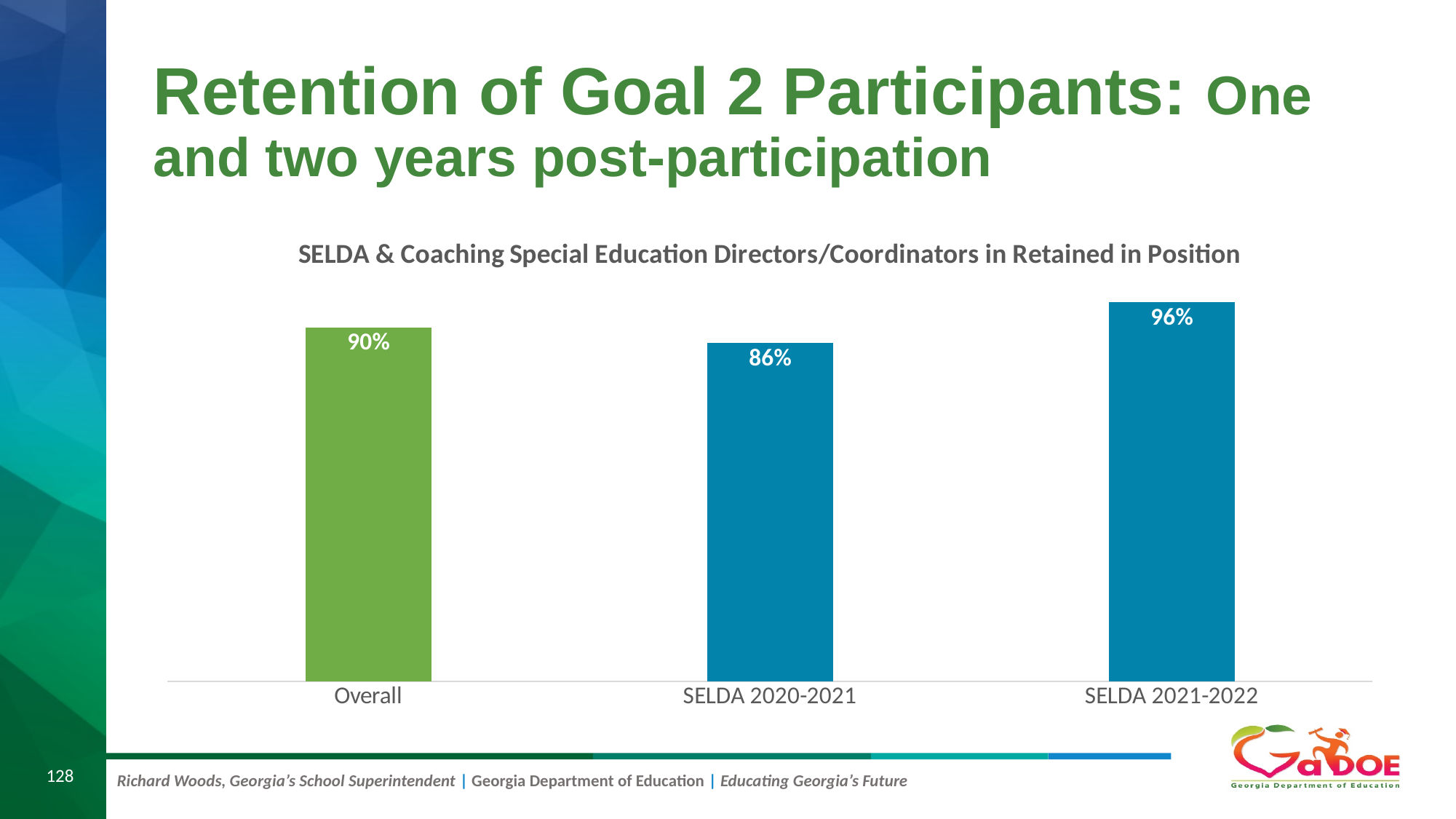
Which category has the highest value? SELDA 2021-2022 What is the title of the chart? SELDA & Coaching Special Education Directors/Coordinators in Retained in Position What is the value for SELDA 2021-2022? 96% Which category's bar is coloured green rather than blue? Overall What kind of chart is shown on the slide? Bar chart How many categories are shown in the chart? 3 Which category has the lowest value? SELDA 2020-2021 Which is larger, the value for Overall or the value for SELDA 2021-2022? SELDA 2021-2022 What is the value for SELDA 2020-2021? 86% What is the difference between the values for SELDA 2021-2022 and SELDA 2020-2021? 10% What is the difference between the values for Overall and SELDA 2020-2021? 4% What is the value for Overall? 90%